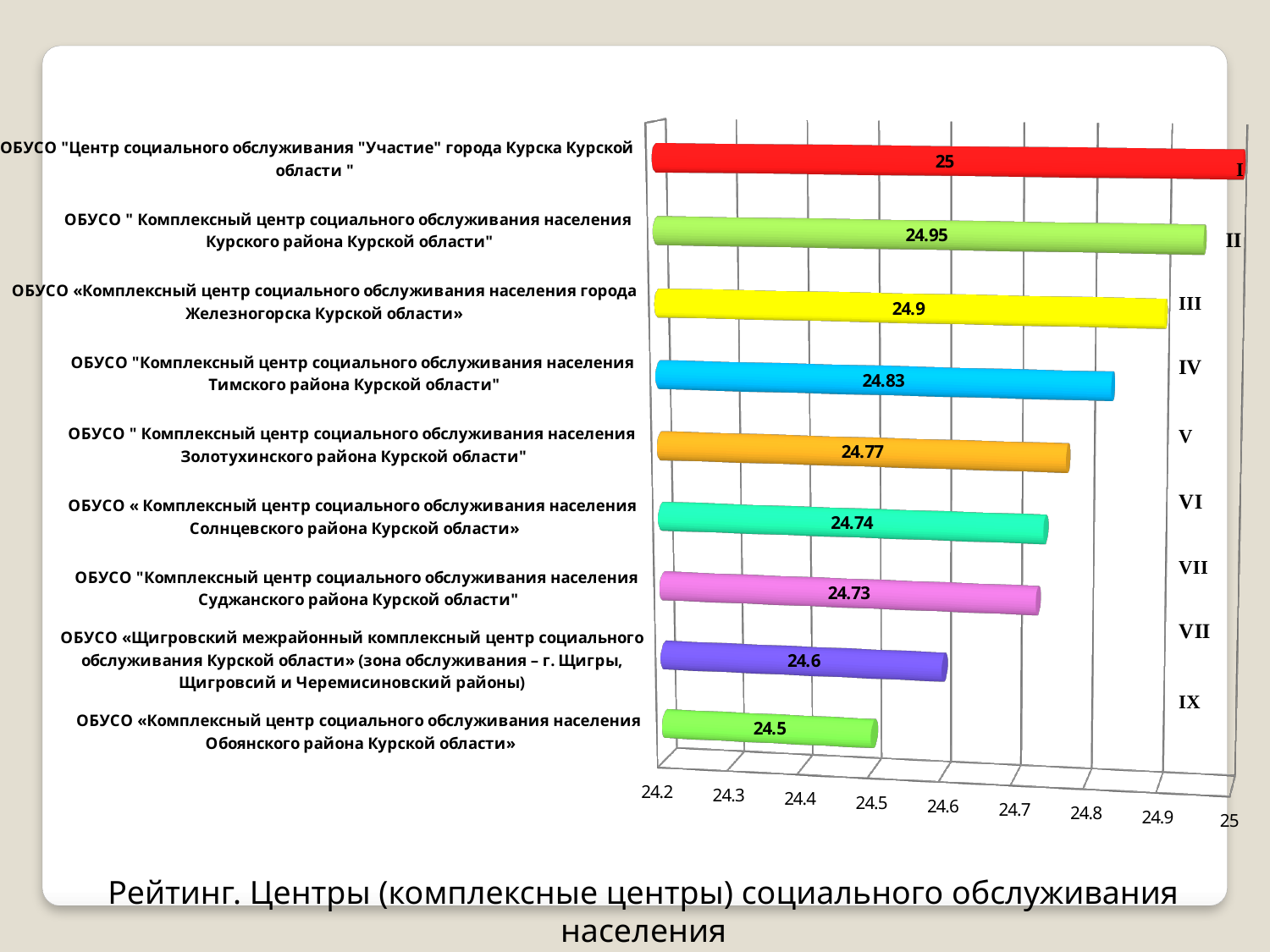
What is the difference between the values for the Курского района centre and the Обоянского района centre? 0.45 How many organisations are shown on the chart? 9 What value is shown for ОБУСО "Комплексный центр социального обслуживания населения Тимского района Курской области"? 24.83 Which has a larger value: the Золотухинского района centre or the Солнцевского района centre? Золотухинского района centre What type of chart is shown on the slide? Bar chart Do the bar values increase or decrease from the top of the chart to the bottom? Decrease What value is shown for ОБУСО "Центр социального обслуживания "Участие" города Курска Курской области"? 25 What value is shown for ОБУСО «Щигровский межрайонный комплексный центр социального обслуживания Курской области»? 24.6 What rank label is shown next to the bar for the города Железногорска centre? III What value is shown for ОБУСО «Комплексный центр социального обслуживания населения Обоянского района Курской области»? 24.5 Which organisation has the lowest value on the chart? ОБУСО «Комплексный центр социального обслуживания населения Обоянского района Курской области» Which organisation has the highest value on the chart? ОБУСО "Центр социального обслуживания "Участие" города Курска Курской области"